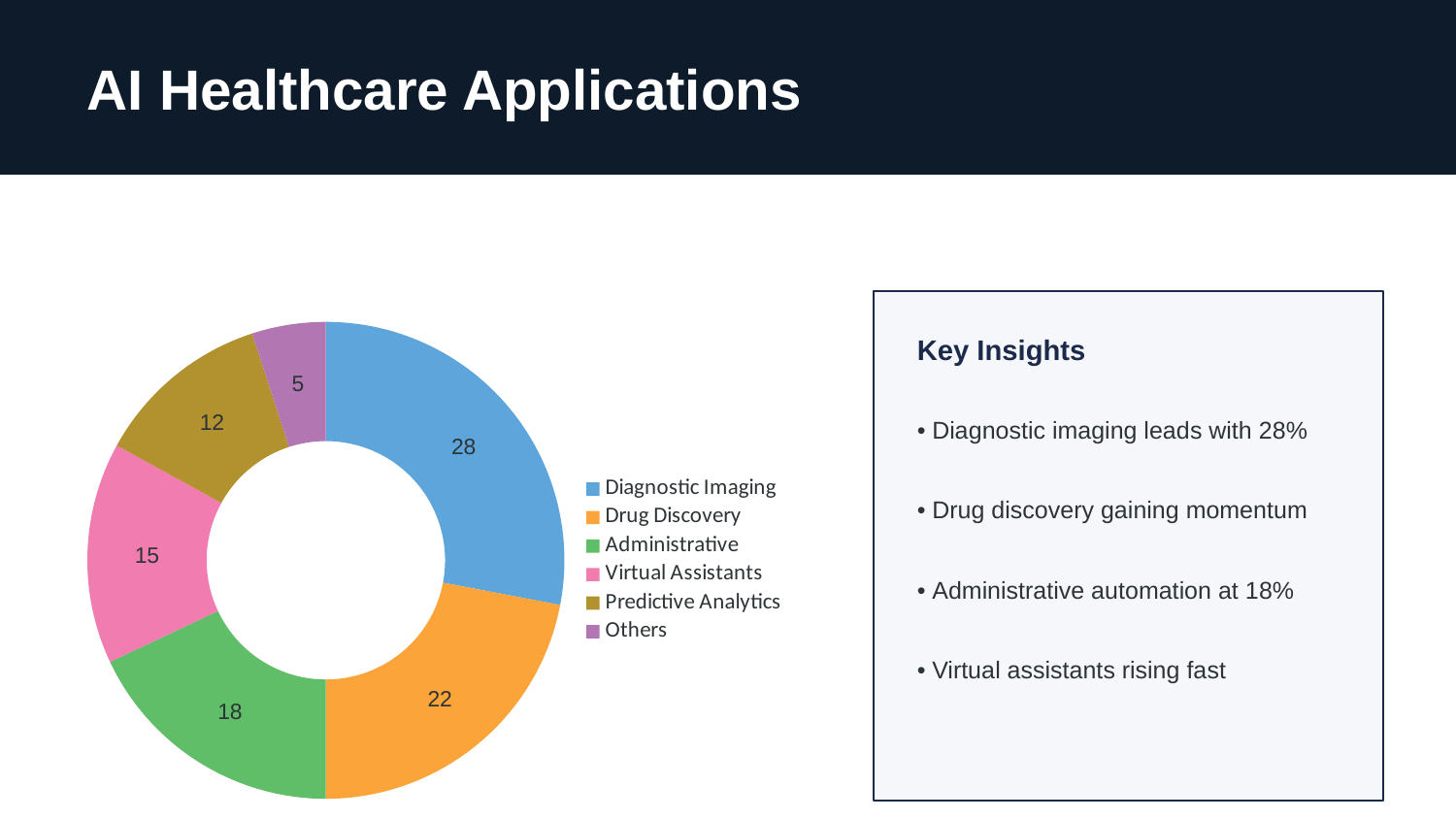
What is the difference between the values for Drug Discovery and Administrative? 4 Which category has the largest slice? Diagnostic Imaging Which category has the smallest slice? Others What share of the whole does the Drug Discovery slice represent? 22% What kind of chart is shown on the slide? Doughnut chart Which is larger, the value for Administrative or the value for Virtual Assistants? Administrative What is the value for Diagnostic Imaging? 28 What is the value for Predictive Analytics? 12 What is the total of all the slice values? 100 What colour is the Administrative slice? Green What is the value for Virtual Assistants? 15 How many categories does the chart show? 6